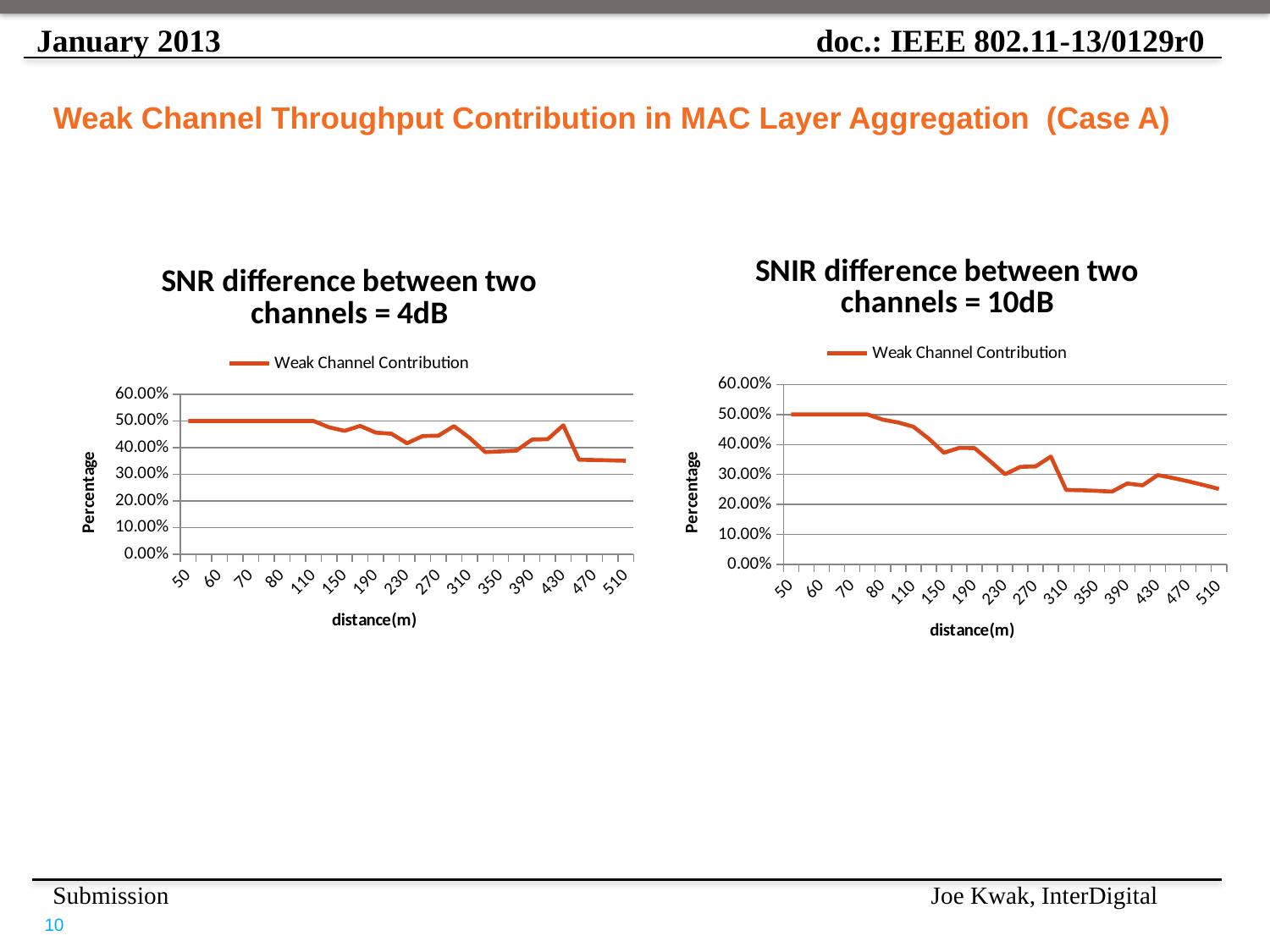
In the left chart (SNR difference = 4dB), what is the value of Weak Channel Contribution at a distance of 50 m? 50.00% In the left chart (SNR difference = 4dB), is the value at a distance of 430 m greater or less than 40.00%? greater In the left chart (SNR difference = 4dB), which distance has the larger Weak Channel Contribution, 50 m or 510 m? 50 m In the right chart (SNIR difference = 10dB), does the Weak Channel Contribution generally rise or fall as distance increases? fall In the left chart (SNR difference = 4dB), is the value at a distance of 510 m greater or less than 40.00%? less In the right chart (SNIR difference = 10dB), what is the value of Weak Channel Contribution at a distance of 50 m? 50.00% In the right chart (SNIR difference = 10dB), what is the name of the series shown in the legend? Weak Channel Contribution In the left chart (SNR difference = 4dB), how many series does the legend list? 1 What type of chart is the left chart titled "SNR difference between two channels = 4dB"? line chart In the right chart (SNIR difference = 10dB), is the value at a distance of 510 m greater or less than 30.00%? less What is the label on the x axis of the right chart (SNIR difference = 10dB)? distance(m)